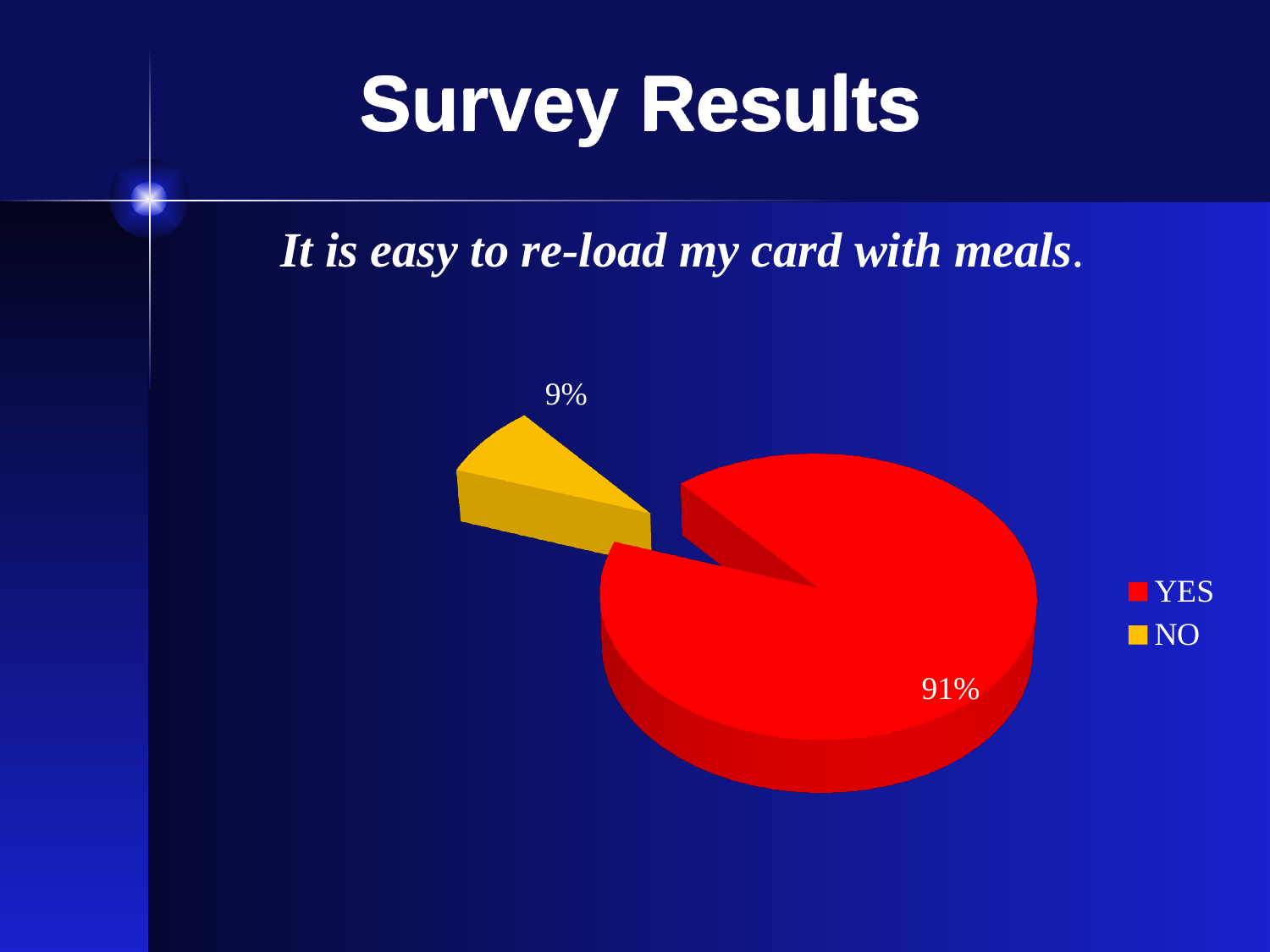
What survey statement does the pie chart show results for? It is easy to re-load my card with meals. What percentage of respondents answered NO? 9% Which is larger, the YES share or the NO share? YES What percentage of respondents answered YES? 91% What is the difference in percentage points between the YES and NO shares? 82 What kind of chart is shown on the slide? pie chart Which response has the largest share of the pie? YES Which response has the smallest share of the pie? NO How many slices does the pie chart have? 2 What share of the pie does the NO slice represent? 9% How many entries does the legend list? 2 What colour is the YES slice? red